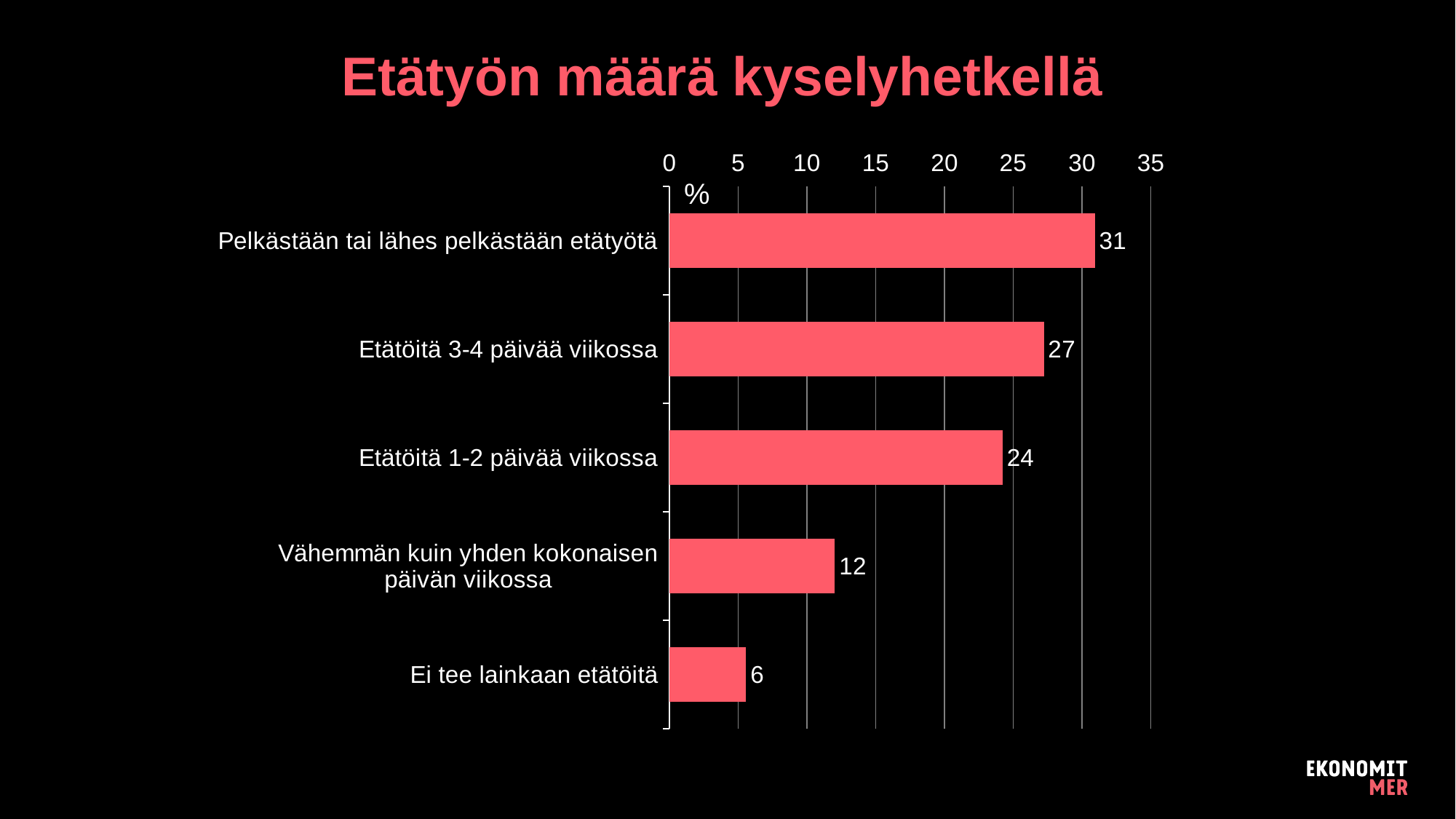
What is the title of the chart? Etätyön määrä kyselyhetkellä What is the value for "Vähemmän kuin yhden kokonaisen päivän viikossa"? 12 Which is larger: the value for "Etätöitä 1-2 päivää viikossa" or "Vähemmän kuin yhden kokonaisen päivän viikossa"? Etätöitä 1-2 päivää viikossa What is the value for "Pelkästään tai lähes pelkästään etätyötä"? 31 What is the value for "Ei tee lainkaan etätöitä"? 6 Which category has the lowest value? Ei tee lainkaan etätöitä How many categories are shown in the chart? 5 What kind of chart is shown on the slide? Bar chart Which category has the highest value? Pelkästään tai lähes pelkästään etätyötä What is the value for "Etätöitä 3-4 päivää viikossa"? 27 What is the value for "Etätöitä 1-2 päivää viikossa"? 24 What is the difference between the values for "Pelkästään tai lähes pelkästään etätyötä" and "Etätöitä 3-4 päivää viikossa"? 4